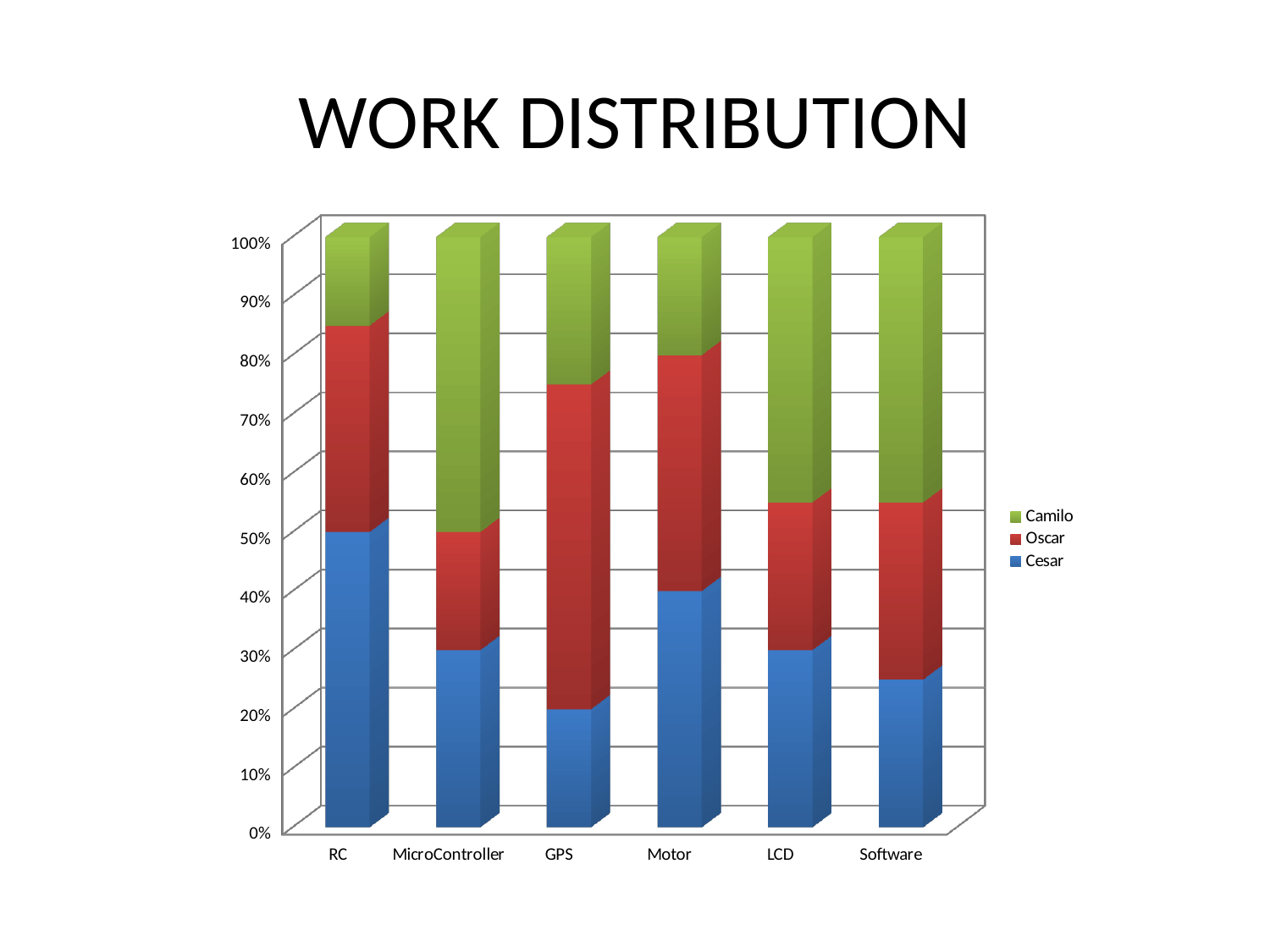
What is the title of the chart? WORK DISTRIBUTION In which category is Cesar's share the largest? RC Is the value for Cesar in the GPS category greater or less than 30%? less What is the total height of the RC stacked bar? 100% Is the value for Cesar in the Software category greater or less than 30%? less Which is larger, Camilo's share for RC or Camilo's share for MicroController? MicroController In which category is Cesar's share the smallest? GPS Which names are listed in the legend? Camilo, Oscar, Cesar Is the value for Cesar in the Motor category greater or less than 30%? greater How many series does the legend list? 3 What kind of chart is shown on the slide? stacked bar chart How many categories are shown on the x axis? 6